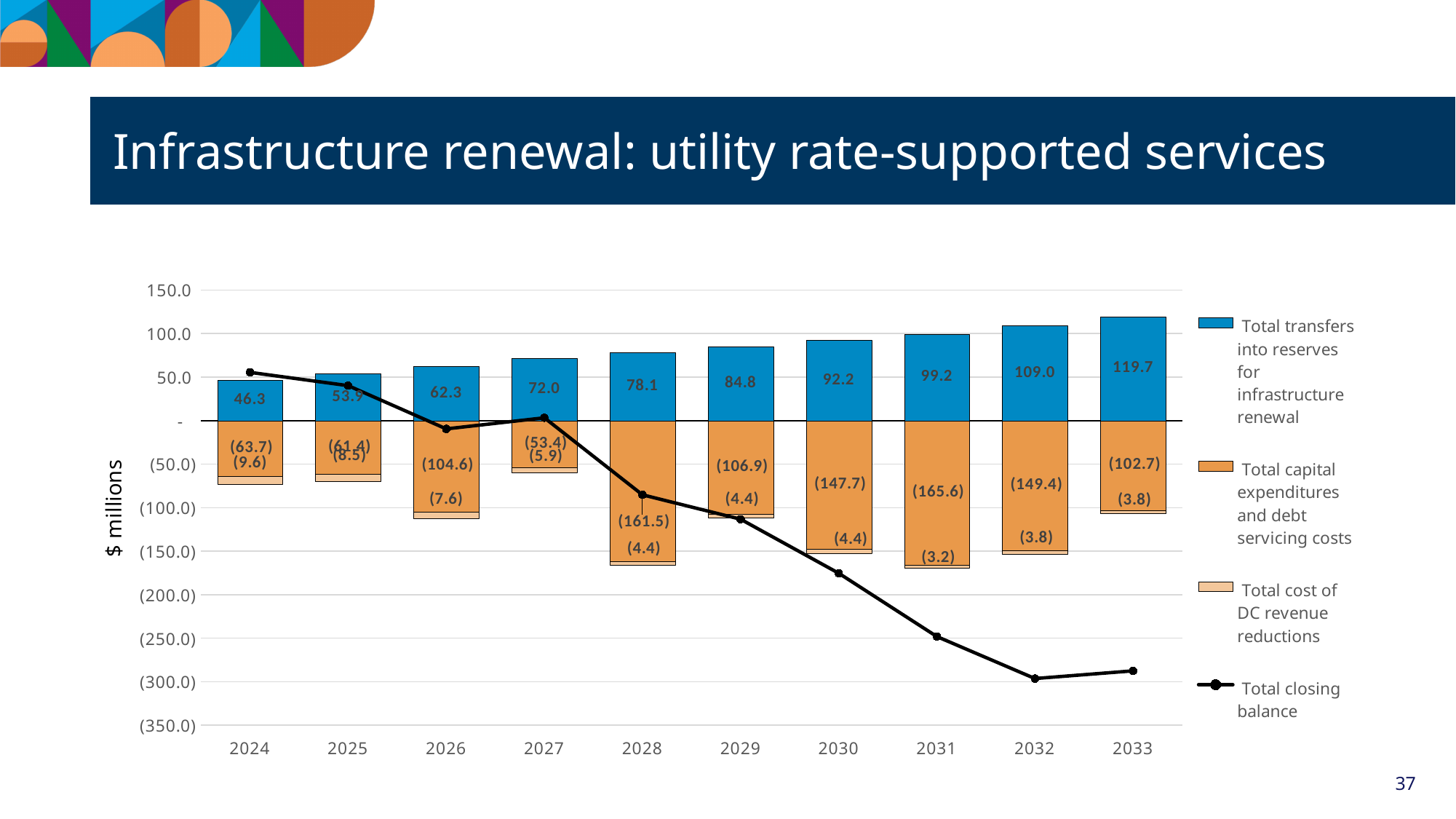
How many series does the legend list? 4 Do the values for Total transfers into reserves for infrastructure renewal rise or fall from 2024 to 2033? rise Which year has the highest value for Total transfers into reserves for infrastructure renewal? 2033 What is the value for Total capital expenditures and debt servicing costs in 2028? (161.5) What is the value for Total cost of DC revenue reductions in 2024? (9.6) How many years are shown on the x axis? 10 By how much does Total transfers into reserves for infrastructure renewal in 2033 exceed the value in 2024? 73.4 Which year has the lowest value for Total transfers into reserves for infrastructure renewal? 2024 Is the Total closing balance for 2032 greater or less than (250.0)? less Which year shows the larger Total capital expenditures and debt servicing costs, 2030 or 2031? 2031 What is the value for Total transfers into reserves for infrastructure renewal in 2030? 92.2 What kind of chart is shown on the slide? Stacked bar chart with a line